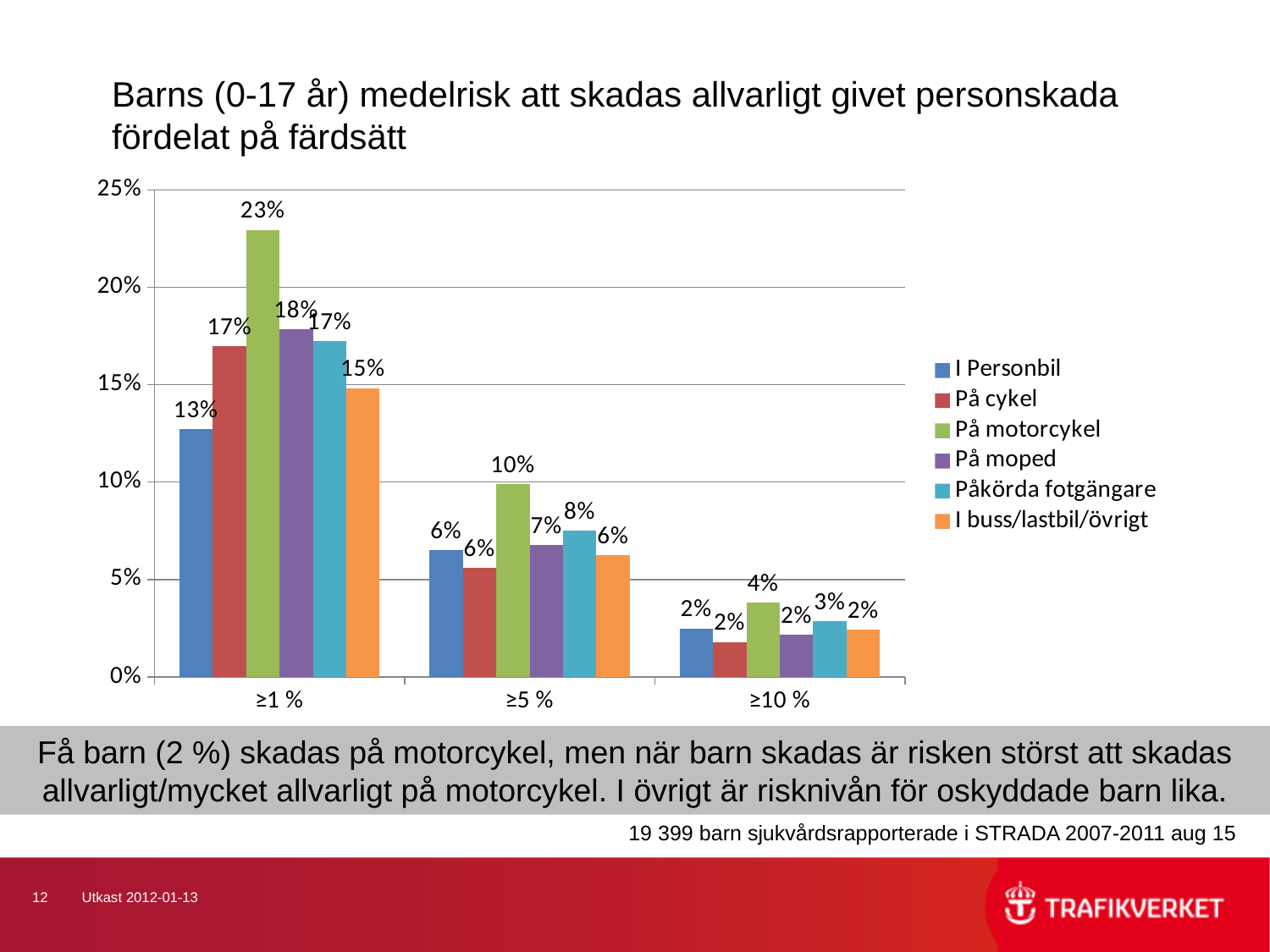
How many series does the legend list? 6 How many categories are shown on the x axis? 3 Which series has the highest value in the ≥1 % category? På motorcykel Does the value for På motorcykel fall or rise from ≥1 % to ≥10 %? fall What type of chart is shown on the slide? bar chart What is the value for Påkörda fotgängare in the ≥5 % category? 8% Which series has the lowest value in the ≥1 % category? I Personbil What is the difference between På motorcykel and I Personbil in the ≥1 % category? 10% What is the value for På motorcykel in the ≥10 % category? 4% In the ≥5 % category, which is larger: På motorcykel or På moped? På motorcykel What is the value for I Personbil in the ≥1 % category? 13% What is the value for På motorcykel in the ≥1 % category? 23%